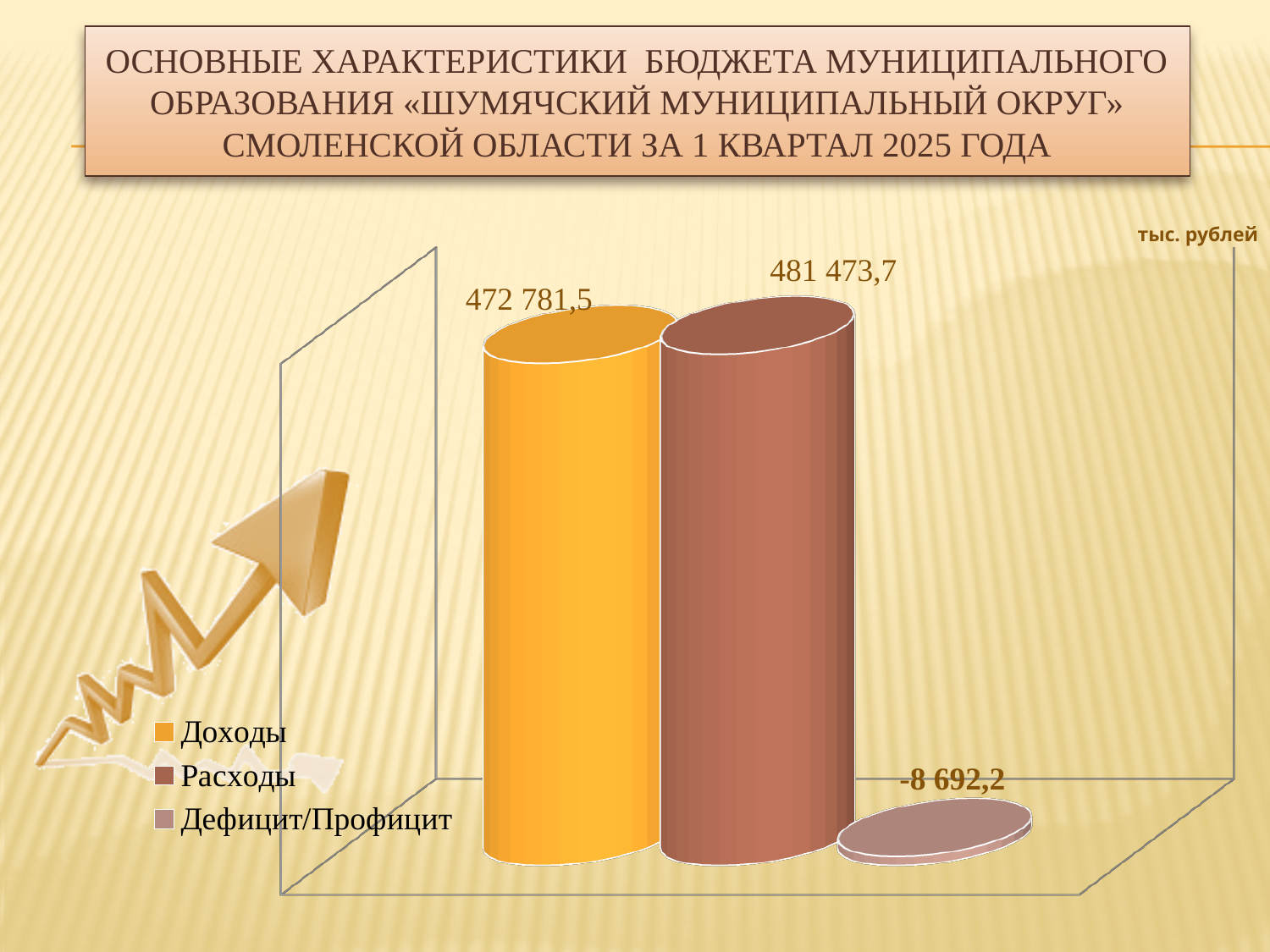
What colour is the bar for Доходы? Orange Which is larger, Доходы or Расходы? Расходы Which series has the highest value? Расходы What is the value for Расходы? 481 473,7 What kind of chart is shown on the slide? Bar chart Which series has the lowest value? Дефицит/Профицит How many series does the legend list? 3 What is the value for Доходы? 472 781,5 What is the difference between Расходы and Доходы? 8 692,2 What is the value for Дефицит/Профицит? -8 692,2 What unit of measurement is indicated for the chart values? тыс. рублей How many bars are plotted on the chart? 3